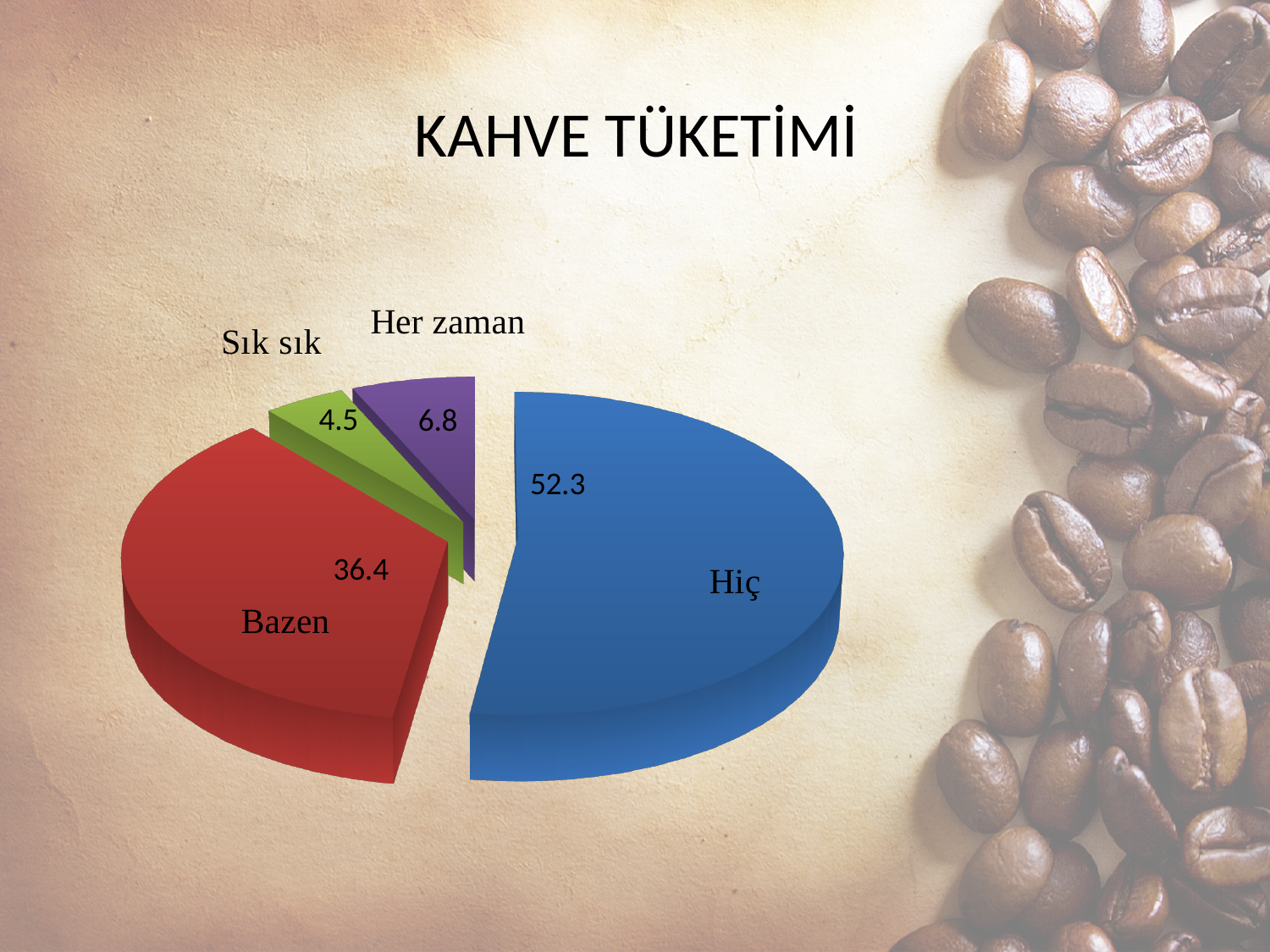
How many slices does the pie chart have? 4 What is the value for Her zaman? 6.8 Which category has the smallest slice? Sık sık What is the title of the slide containing the chart? KAHVE TÜKETİMİ What is the difference between the values for Her zaman and Sık sık? 2.3 What is the difference between the values for Hiç and Bazen? 15.9 Which is larger, the value for Her zaman or the value for Sık sık? Her zaman What is the value for Bazen? 36.4 Which category has the largest slice? Hiç What kind of chart is shown on the slide? pie chart What is the value for Hiç? 52.3 What is the value for Sık sık? 4.5